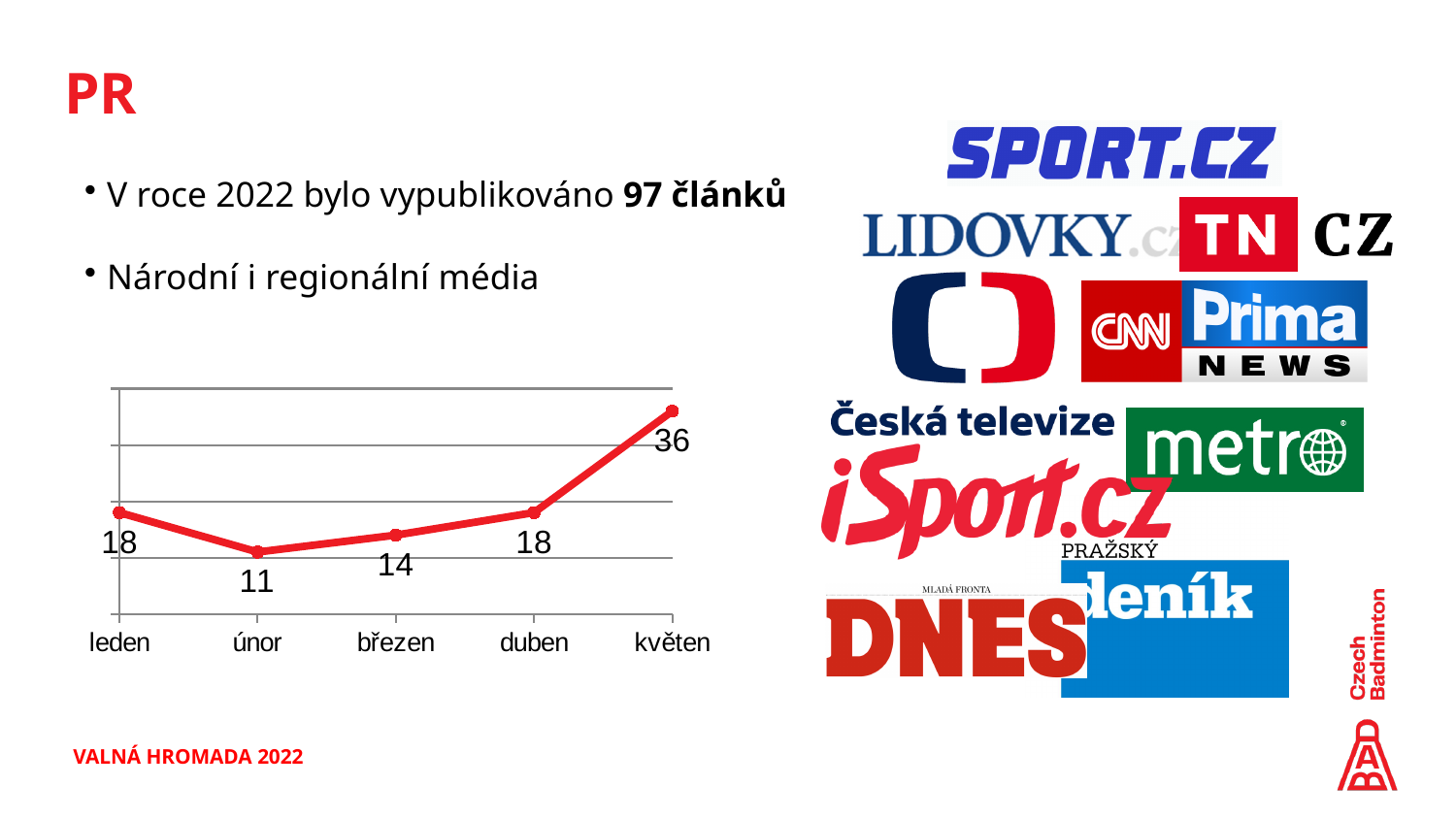
Which is larger, the value for březen or the value for duben? duben What is the difference between the values for leden and únor? 7 What is the value for květen in the line chart? 36 What kind of chart is shown on the slide? line chart What is the difference between the values for květen and duben? 18 Which month has the lowest value in the line chart? únor What is the total of the values plotted for all five months? 97 What is the value for březen in the line chart? 14 Do the values rise or fall from únor to květen? rise What is the value for únor in the line chart? 11 How many months are plotted in the line chart? 5 Which month has the highest value in the line chart? květen